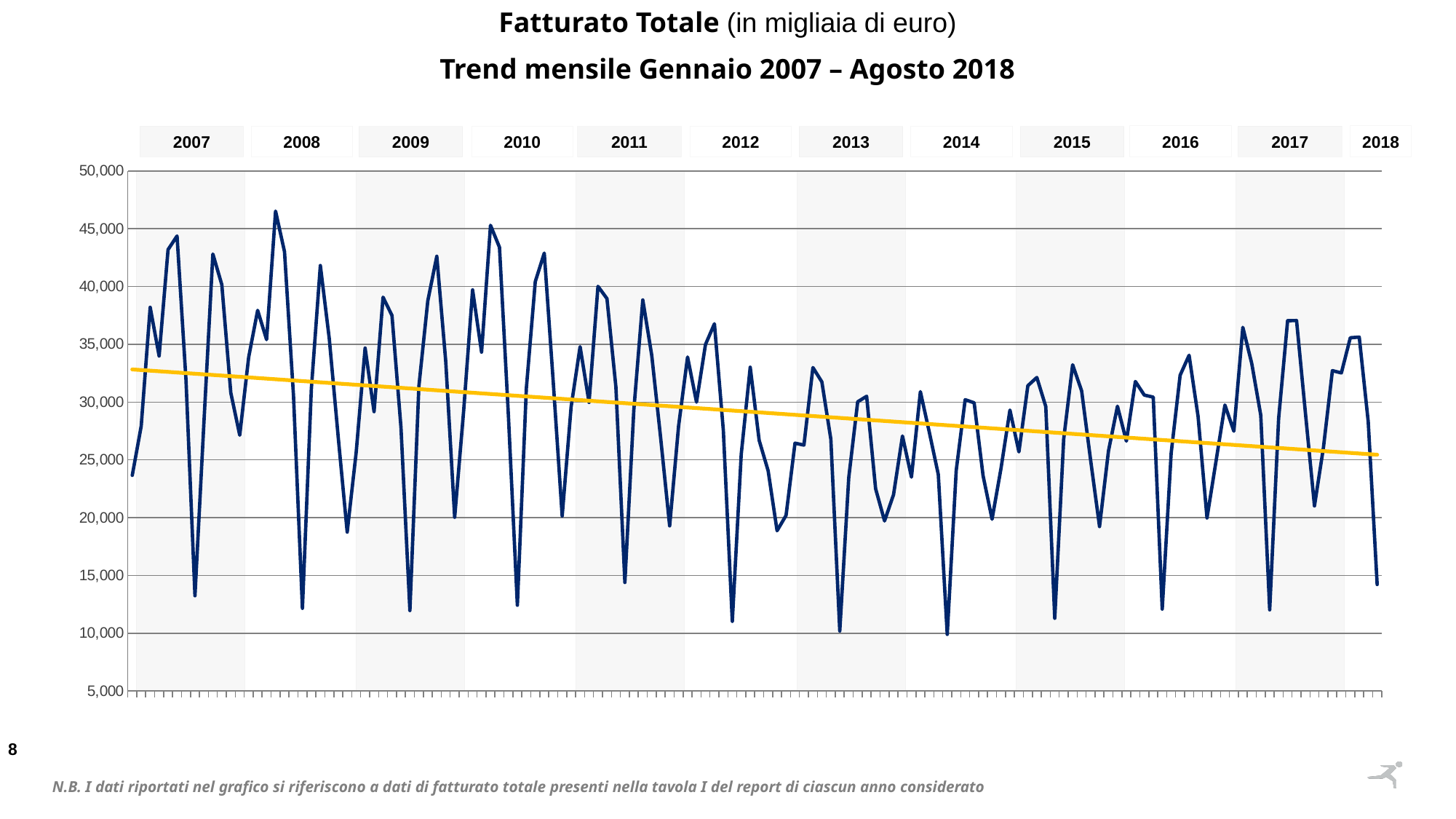
What is the title of the chart? Fatturato Totale (in migliaia di euro) – Trend mensile Gennaio 2007 – Agosto 2018 Is the highest peak in 2008 greater or less than 45,000? greater Is the lowest point in 2012 greater or less than 10,000? greater How many year labels are shown along the top of the chart? 12 Does the yellow trend line rise or fall from 2007 to 2018? fall Is the highest peak in 2017 greater or less than 35,000? greater What kind of chart is shown on the slide? line chart In which year does the monthly line reach its highest peak? 2008 What is the highest value shown on the vertical axis? 50,000